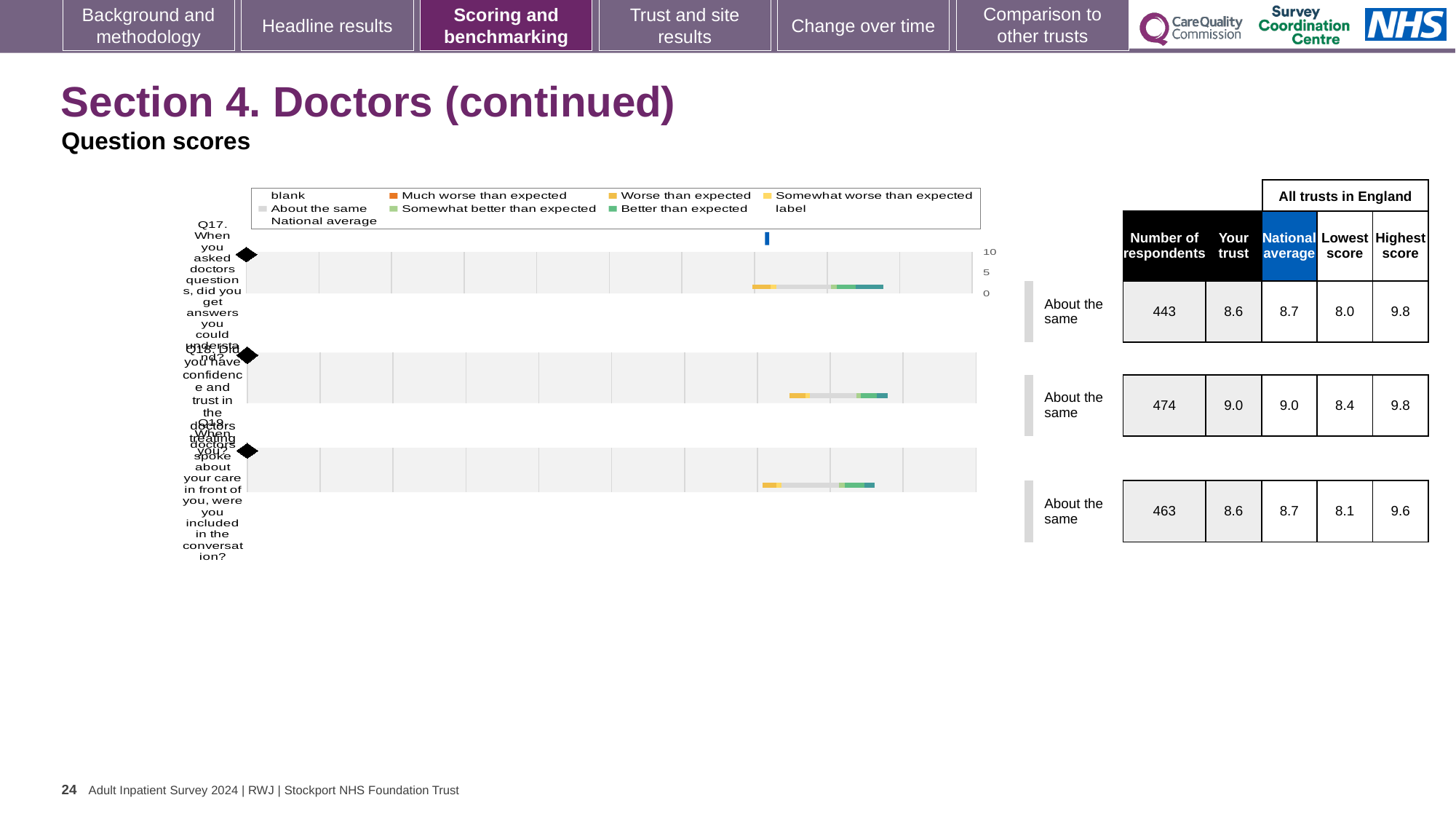
How many questions (Q17, Q18, Q19) are plotted in the chart? 3 What colour does the legend use for 'Much worse than expected'? Orange Which question has the highest 'Your trust' score? Q18 What benchmark category is shown for Q17? About the same What is the national average score for Q19 (included in the conversation)? 8.7 What is the 'Your trust' score for Q17 (answers you could understand)? 8.6 What is the difference between the 'Your trust' scores for Q18 and Q17? 0.4 For Q19, which is larger: the 'Your trust' score or the national average? National average What is the number of respondents for Q18 (confidence and trust in the doctors treating you)? 474 What is the highest score across all trusts in England for Q18? 9.8 Which question has the lowest 'Lowest score' across all trusts in England? Q17 What kind of chart is shown on the slide? bar chart